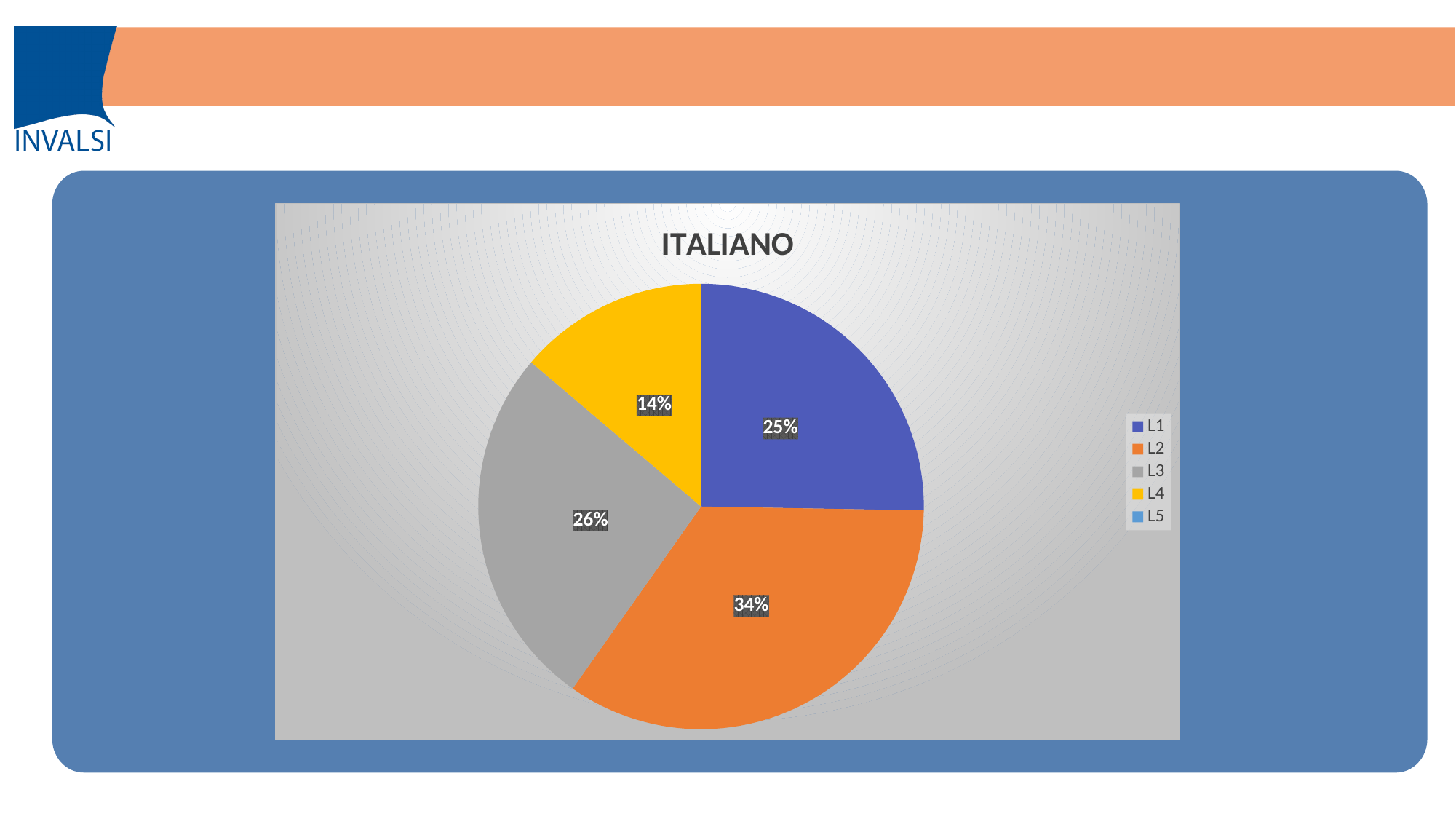
What percentage is shown for L2? 34% Which is larger, the share for L1 or the share for L3? L3 What percentage is shown for L1? 25% Which level has the largest slice of the pie? L2 What percentage is shown for L3? 26% What type of chart is shown on the slide? pie chart What is the title of the chart? ITALIANO What percentage is shown for L4? 14% How many entries does the legend list? 5 Which labelled slice is the smallest? L4 What is the difference in percentage points between L2 and L4? 20 What colour is the slice for L4? yellow